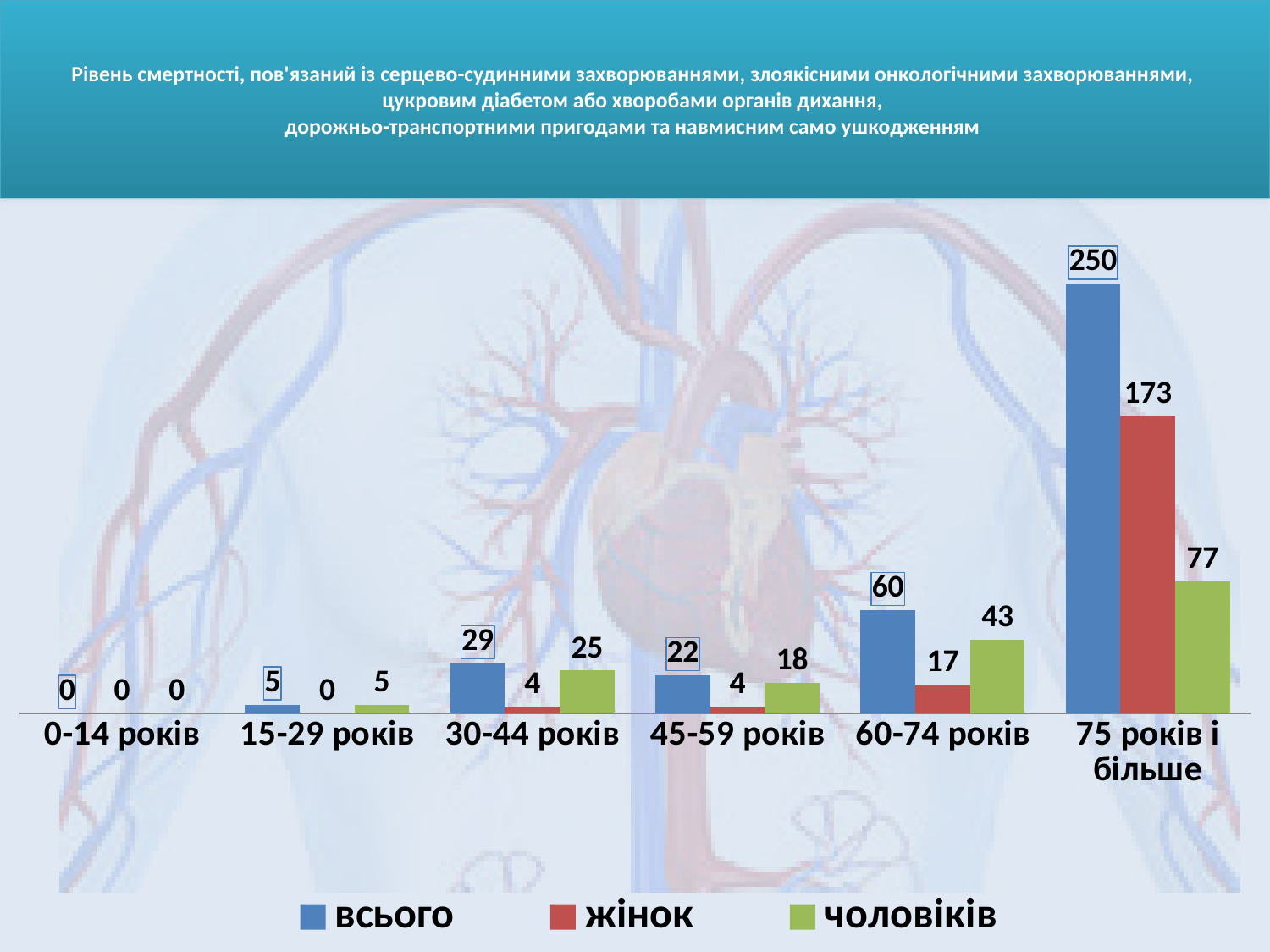
Which age group has the lowest "чоловіків" value? 0-14 років Which age group has the highest "всього" value? 75 років і більше What is the value of "жінок" for the "15-29 років" age group? 0 How many age groups are shown on the x axis? 6 Which is larger for the "60-74 років" age group: "жінок" or "чоловіків"? чоловіків How many series does the legend list? 3 What colour are the "жінок" bars? red What is the value of "жінок" for the "60-74 років" age group? 17 What kind of chart is shown on the slide? bar chart What is the value of "чоловіків" for the "30-44 років" age group? 25 What is the value of "всього" for the "75 років і більше" age group? 250 What is the difference between the "жінок" and "чоловіків" values for the "75 років і більше" age group? 96